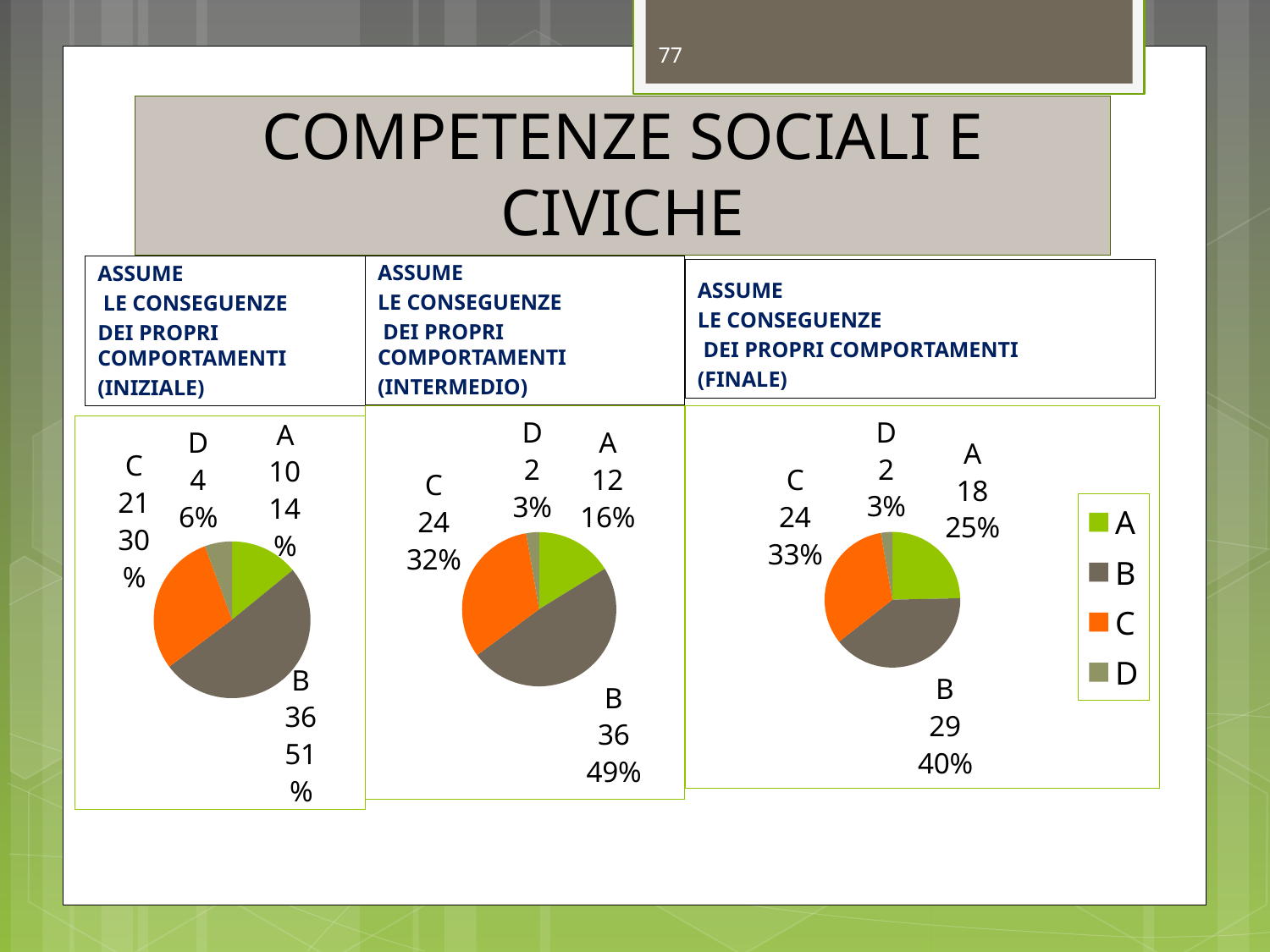
In the legend next to the FINALE chart, which colour represents category C? Orange In the INIZIALE pie chart, what count is shown for category C? 21 How many entries does the legend next to the FINALE chart list? 4 What type of chart is used for the INTERMEDIO data? Pie chart In the INIZIALE pie chart, what percentage is shown for category B? 51% In the INIZIALE pie chart, which category has the smallest share? D In the INTERMEDIO pie chart, what is the difference in count between category B and category A? 24 How many categories does the FINALE pie chart show? 4 In the FINALE pie chart, which is larger, the share for A or the share for C? C In the FINALE pie chart, what count is shown for category A? 18 In the FINALE pie chart, which category has the largest share? B In the INTERMEDIO pie chart, what percentage is shown for category C? 32%